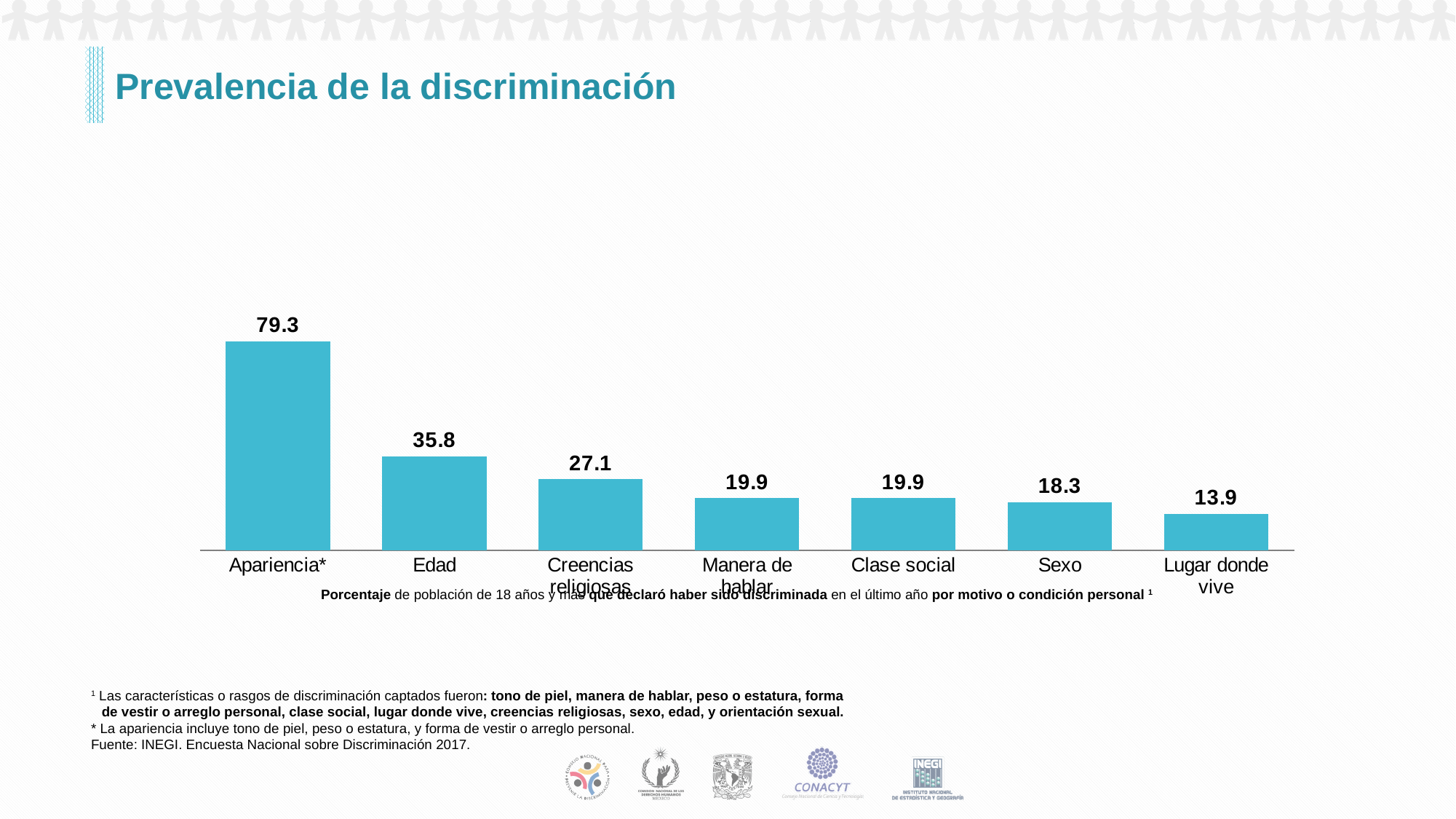
What is the value for Creencias religiosas? 27.1 What is the value for Apariencia*? 79.3 Which is larger, the value for Edad or the value for Creencias religiosas? Edad How many categories are shown in the chart? 7 What is the value for Edad? 35.8 What kind of chart is shown on the slide? Bar chart What is the title of the slide? Prevalencia de la discriminación What is the difference between the values for Clase social and Lugar donde vive? 6.0 Which category has the highest value? Apariencia* Which category has the lowest value? Lugar donde vive What is the value for Sexo? 18.3 What is the difference between the values for Apariencia* and Edad? 43.5